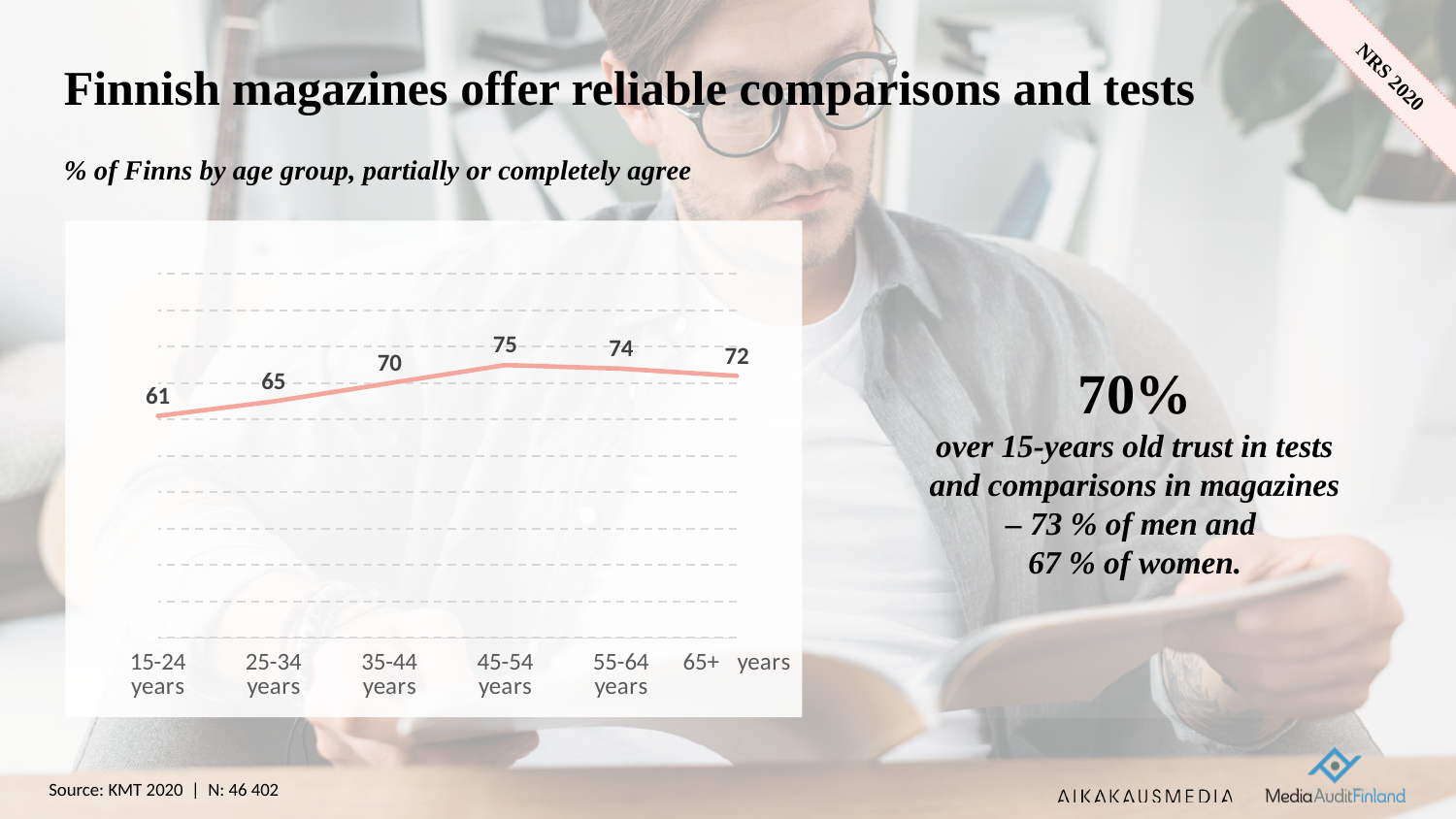
What is the value for the 15-24 years age group? 61 Do the values rise or fall from 15-24 years to 45-54 years? Rise What is the value for the 65+ years age group? 72 What is the difference between the values for 35-44 years and 25-34 years? 5 What is the subtitle describing what the chart measures? % of Finns by age group, partially or completely agree How many age groups are plotted on the chart? 6 Which age group has the highest value? 45-54 years What kind of chart is shown on the slide? Line chart What is the difference between the values for 45-54 years and 15-24 years? 14 What is the value for the 45-54 years age group? 75 Which is larger, the value for 25-34 years or the value for 55-64 years? 55-64 years Which age group has the lowest value? 15-24 years